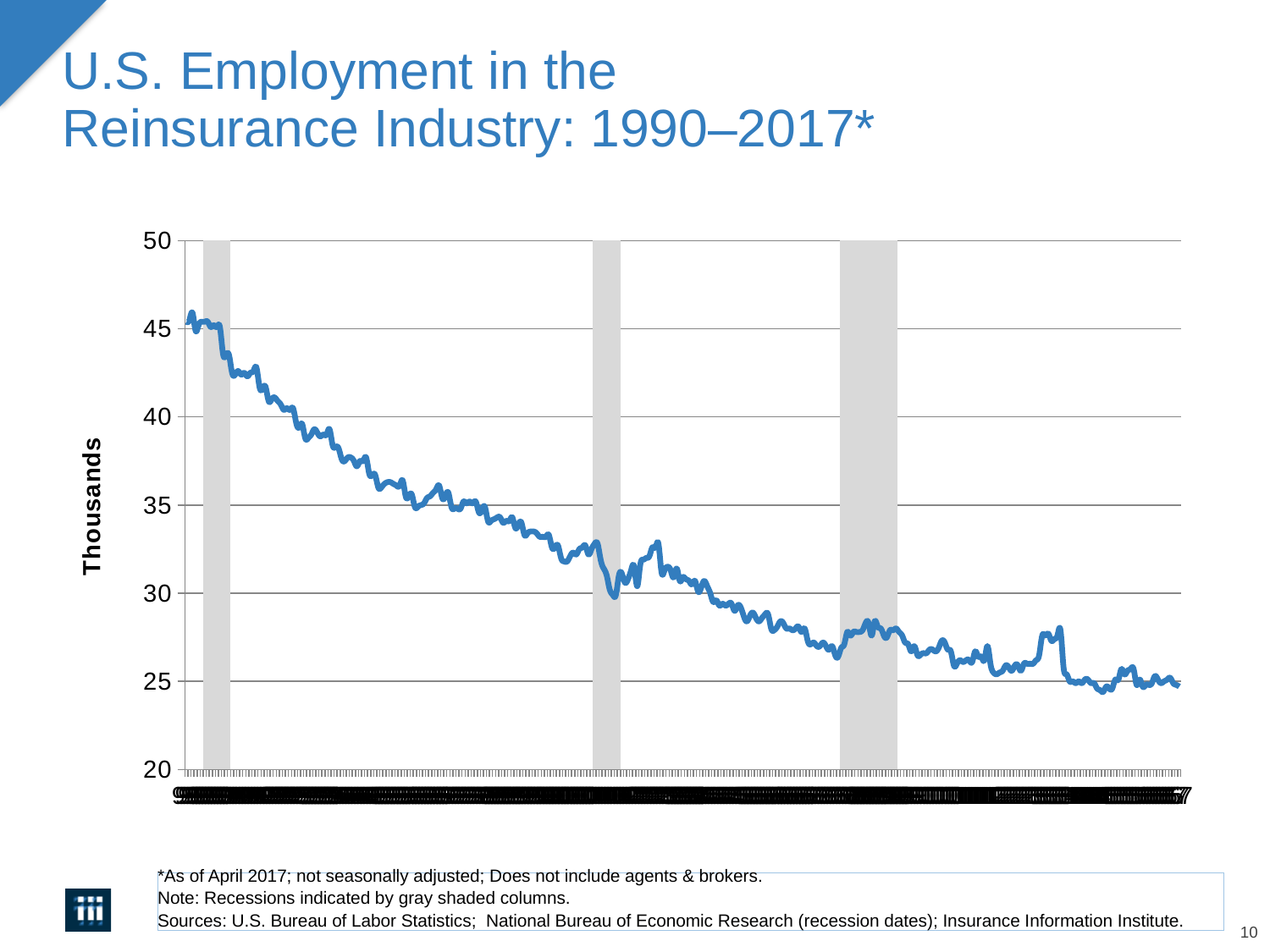
Is the value at the end of the series (right end of the line) greater or less than 20? greater What is the title of the vertical axis? Thousands Is the value at the end of the series (right end of the line) greater or less than 30? less How many gray shaded recession columns are shown on the chart? 3 What kind of chart is shown on the slide? Line chart Is the value at the start of the series (left end of the line) greater or less than 40? greater What is the highest value shown on the vertical axis? 50 Do the values in the chart generally rise or fall from left to right across the period? Fall